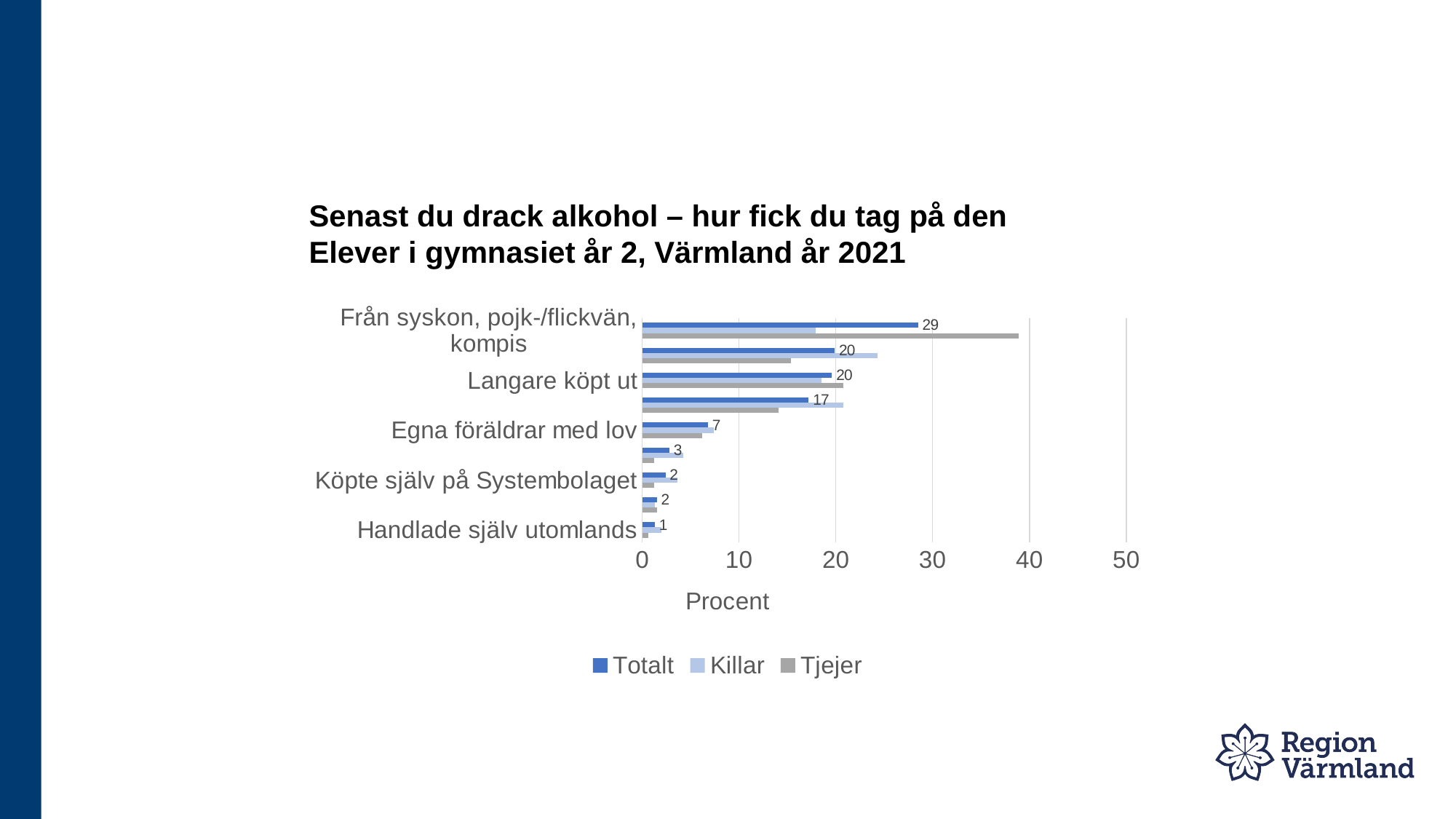
For "Från syskon, pojk-/flickvän, kompis", which is larger: the Killar value or the Tjejer value? Tjejer Which labelled category has the highest Totalt value? Från syskon, pojk-/flickvän, kompis Which labelled category has the lowest Totalt value? Handlade själv utomlands What is the difference between the Totalt values for "Från syskon, pojk-/flickvän, kompis" and "Langare köpt ut"? 9 How many series does the legend list? 3 What is the Totalt value for "Handlade själv utomlands"? 1 What is the Totalt value for "Langare köpt ut"? 20 What kind of chart is shown on the slide? bar chart What is the Totalt value for "Från syskon, pojk-/flickvän, kompis"? 29 What is the Totalt value for "Köpte själv på Systembolaget"? 2 Is the Tjejer value for "Från syskon, pojk-/flickvän, kompis" greater or less than 30? greater What is the Totalt value for "Egna föräldrar med lov"? 7